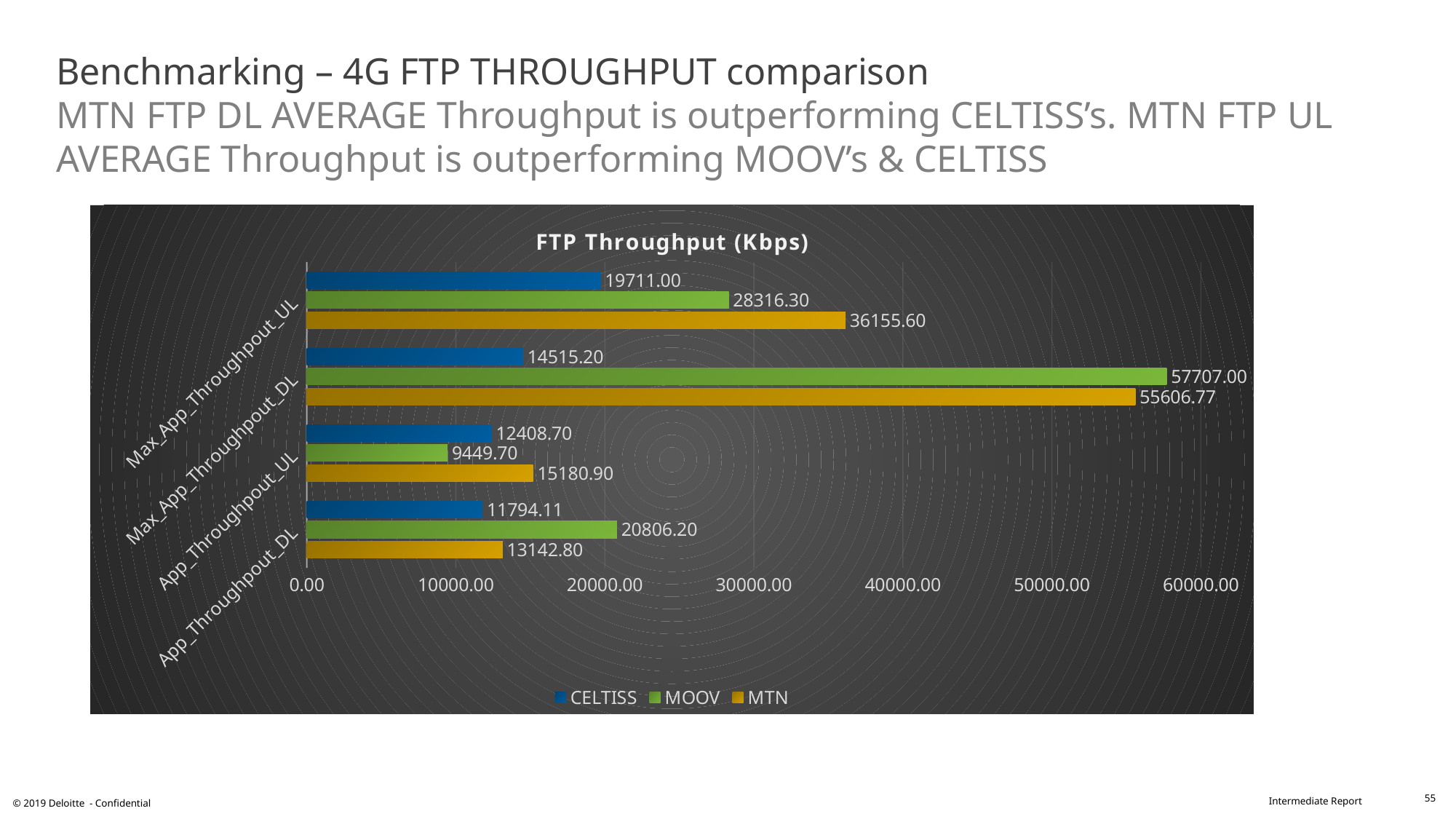
How many categories are shown on the chart? 4 What is the difference between the MTN and CELTISS values for App_Throughpout_UL? 2772.20 How many series does the legend list? 3 Which series has the lowest value for App_Throughpout_UL? MOOV What is the title of the chart? FTP Throughput (Kbps) What kind of chart is shown on the slide? Bar chart Which is larger for Max_App_Throughpout_UL: the MOOV value or the CELTISS value? MOOV What is the MTN value for Max_App_Throughpout_UL? 36155.60 Is the MTN value for Max_App_Throughpout_DL greater or less than 50000.00? greater What is the CELTISS value for Max_App_Throughpout_DL? 14515.20 Which series has the highest value for Max_App_Throughpout_DL? MOOV What is the MOOV value for App_Throughpout_DL? 20806.20